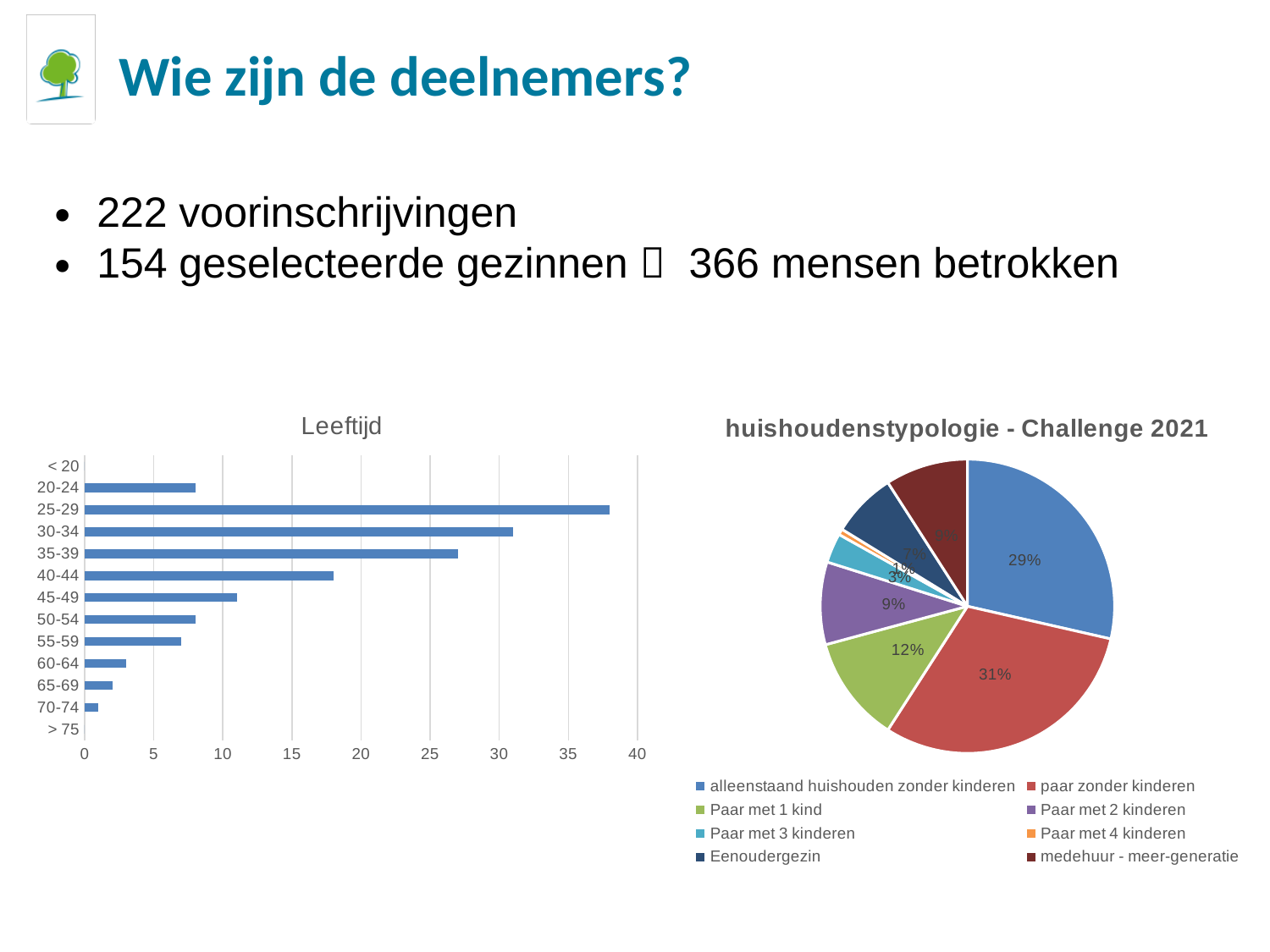
In the 'Leeftijd' chart, is the value for 25-29 greater or less than 35? greater In the 'Leeftijd' chart, which has the larger value, 30-34 or 35-39? 30-34 What kind of chart is the 'Leeftijd' chart? bar chart In the 'huishoudenstypologie - Challenge 2021' pie chart, what share is 'paar zonder kinderen'? 31% How many entries does the legend of the 'huishoudenstypologie - Challenge 2021' pie chart list? 8 In the 'huishoudenstypologie - Challenge 2021' pie chart, what is the difference between the shares of 'paar zonder kinderen' and 'alleenstaand huishouden zonder kinderen'? 2% How many age categories are listed on the 'Leeftijd' chart? 13 In the 'huishoudenstypologie - Challenge 2021' pie chart, which category has the largest slice? paar zonder kinderen In the 'Leeftijd' chart, is the value for 40-44 greater or less than 20? less In the 'huishoudenstypologie - Challenge 2021' pie chart, what share is 'alleenstaand huishouden zonder kinderen'? 29% In the 'huishoudenstypologie - Challenge 2021' pie chart, what share is 'Paar met 1 kind'? 12% In the 'Leeftijd' chart, which age group has the highest value? 25-29